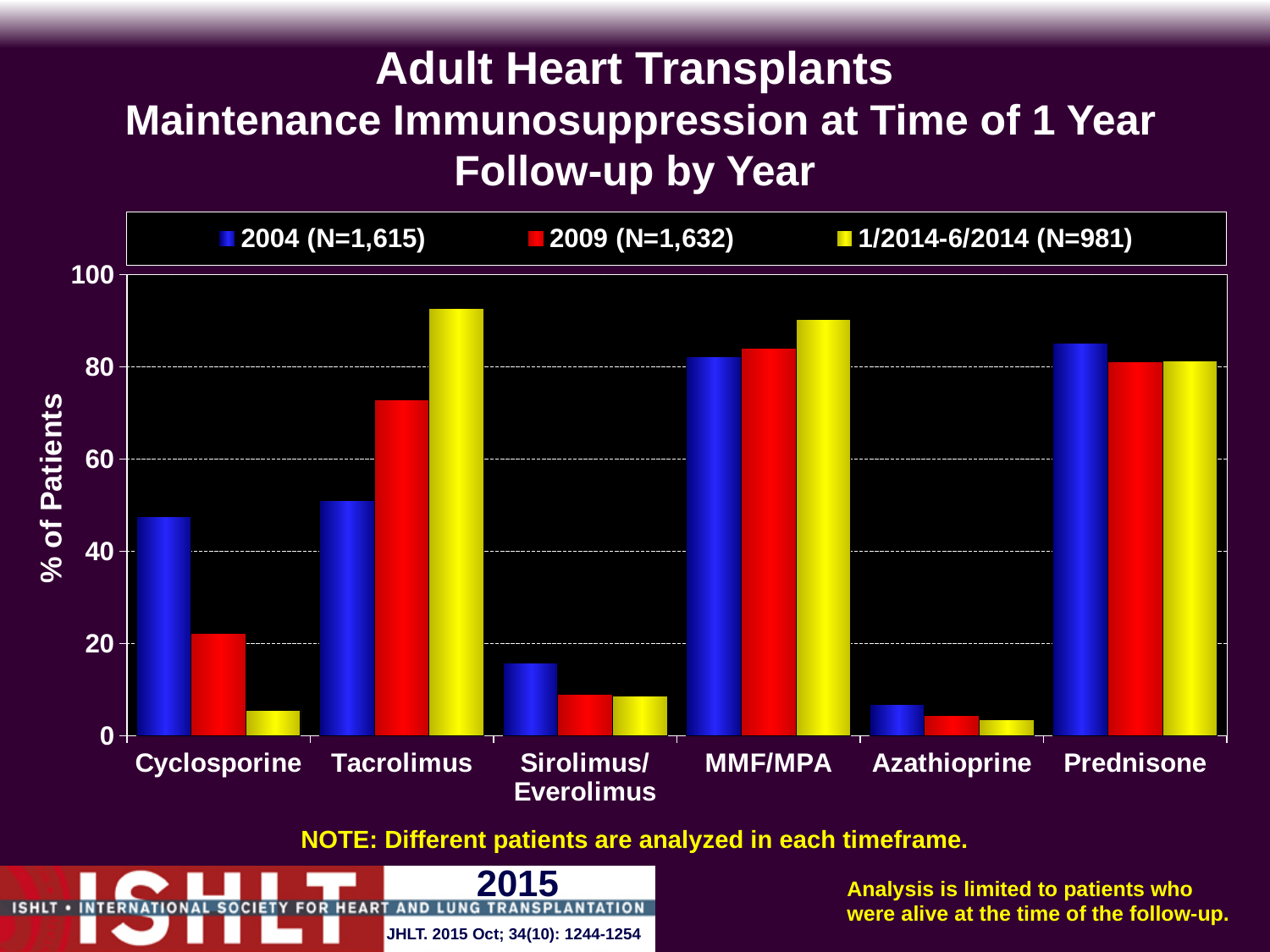
Which drug category has the lowest value for 2004? Azathioprine What is the label on the y axis? % of Patients What kind of chart is shown on the slide? Bar chart In 2009, which is larger: the value for Tacrolimus or the value for Cyclosporine? Tacrolimus Is the value for Cyclosporine in 2004 greater or less than 40? greater For Cyclosporine, which is larger: the 2004 value or the 2009 value? 2004 How many series does the legend list? 3 Is the value for Tacrolimus in 1/2014-6/2014 greater or less than 80? greater Is the value for Sirolimus/Everolimus in 2004 greater or less than 20? less Do the values for Cyclosporine rise or fall from 2004 to 1/2014-6/2014? fall Do the values for Tacrolimus rise or fall from 2004 to 1/2014-6/2014? rise How many drug categories are shown on the x axis? 6